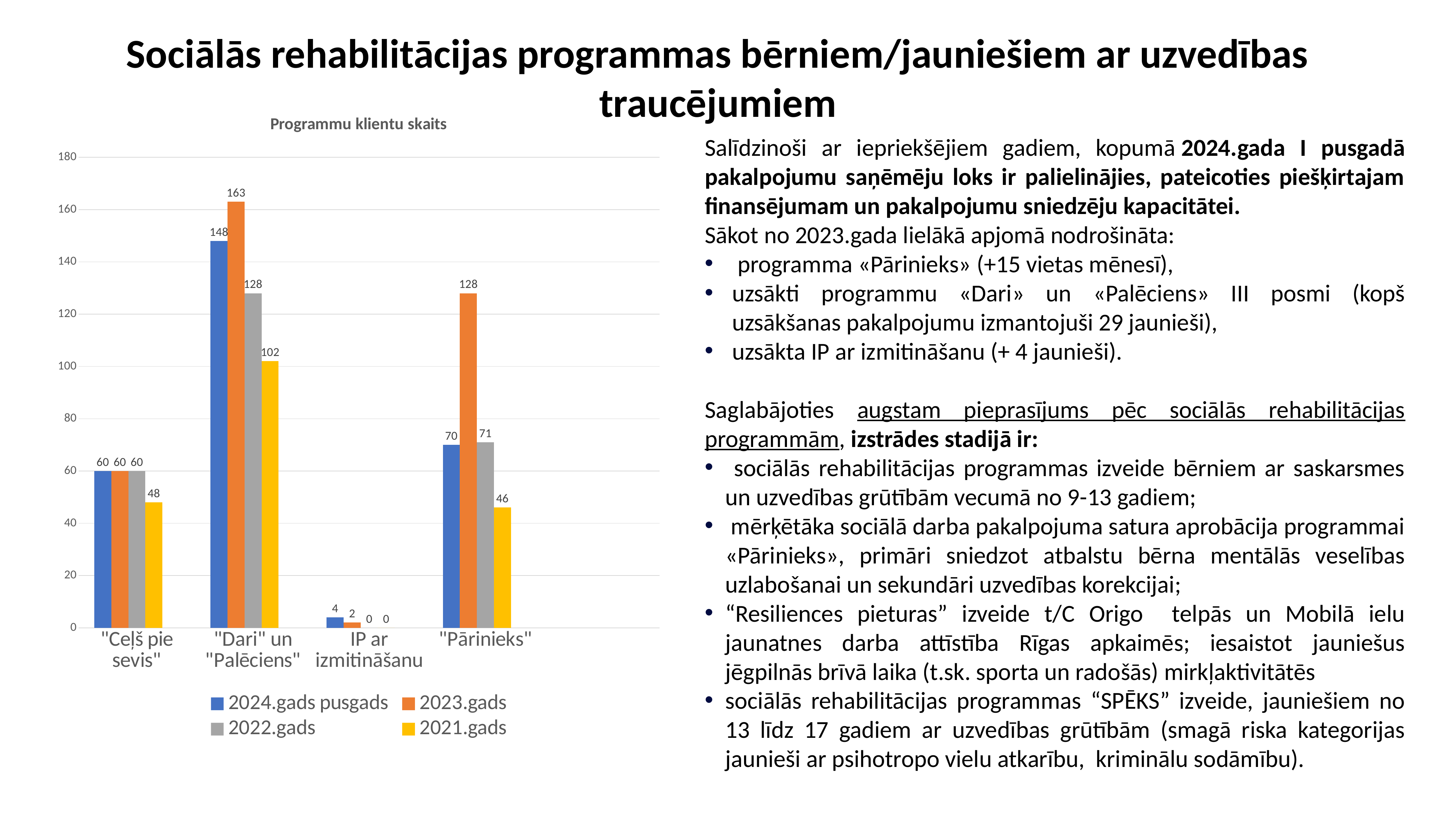
What is the value for IP ar izmitināšanu in the 2024.gads pusgads series? 4 Which category has the highest value in the 2022.gads series? "Dari" un "Palēciens" What is the value for "Pārinieks" in the 2021.gads series? 46 What is the difference between the 2023.gads and 2022.gads values for "Pārinieks"? 57 Is the 2023.gads value for "Pārinieks" greater or less than 100? greater What is the title of the chart? Programmu klientu skaits What is the value for "Dari" un "Palēciens" in the 2023.gads series? 163 How many categories are shown on the x axis? 4 What kind of chart is shown on the slide? bar chart Which is larger for "Dari" un "Palēciens": the 2024.gads pusgads value or the 2021.gads value? 2024.gads pusgads How many series does the legend list? 4 Which category has the lowest value in the 2023.gads series? IP ar izmitināšanu